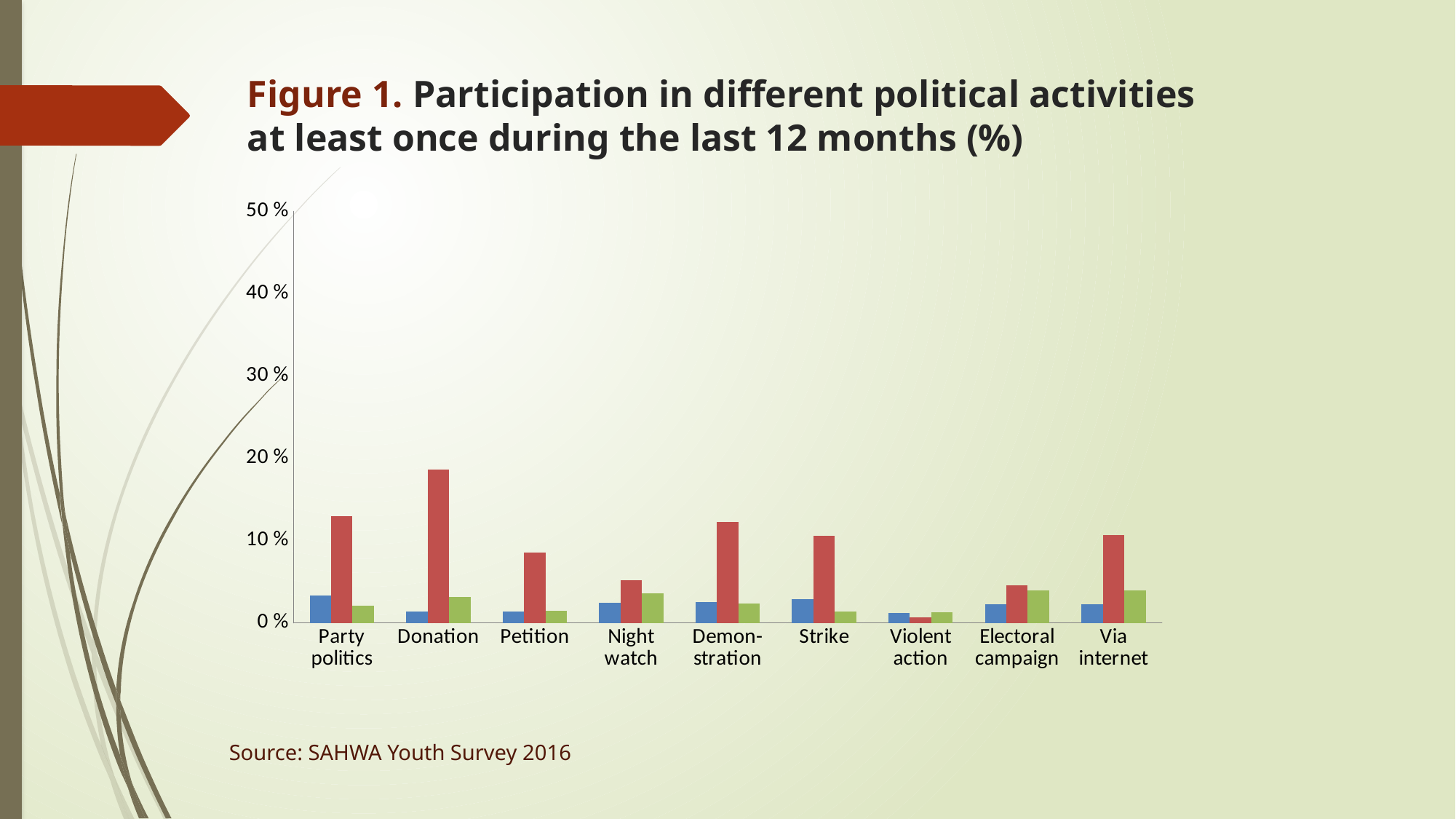
Is the red bar for Electoral campaign greater or less than 10 %? less What is the highest value shown on the vertical axis? 50 % What source is cited below the chart? SAHWA Youth Survey 2016 Which category has the shortest red bar? Violent action Is the red bar for Party politics greater or less than 10 %? greater Is the red bar for Petition greater or less than 10 %? less How many political activity categories are shown on the x axis? 9 What kind of chart is shown on the slide? bar chart Which category has the tallest red bar? Donation Which is larger, the red bar for Donation or the red bar for Party politics? Donation